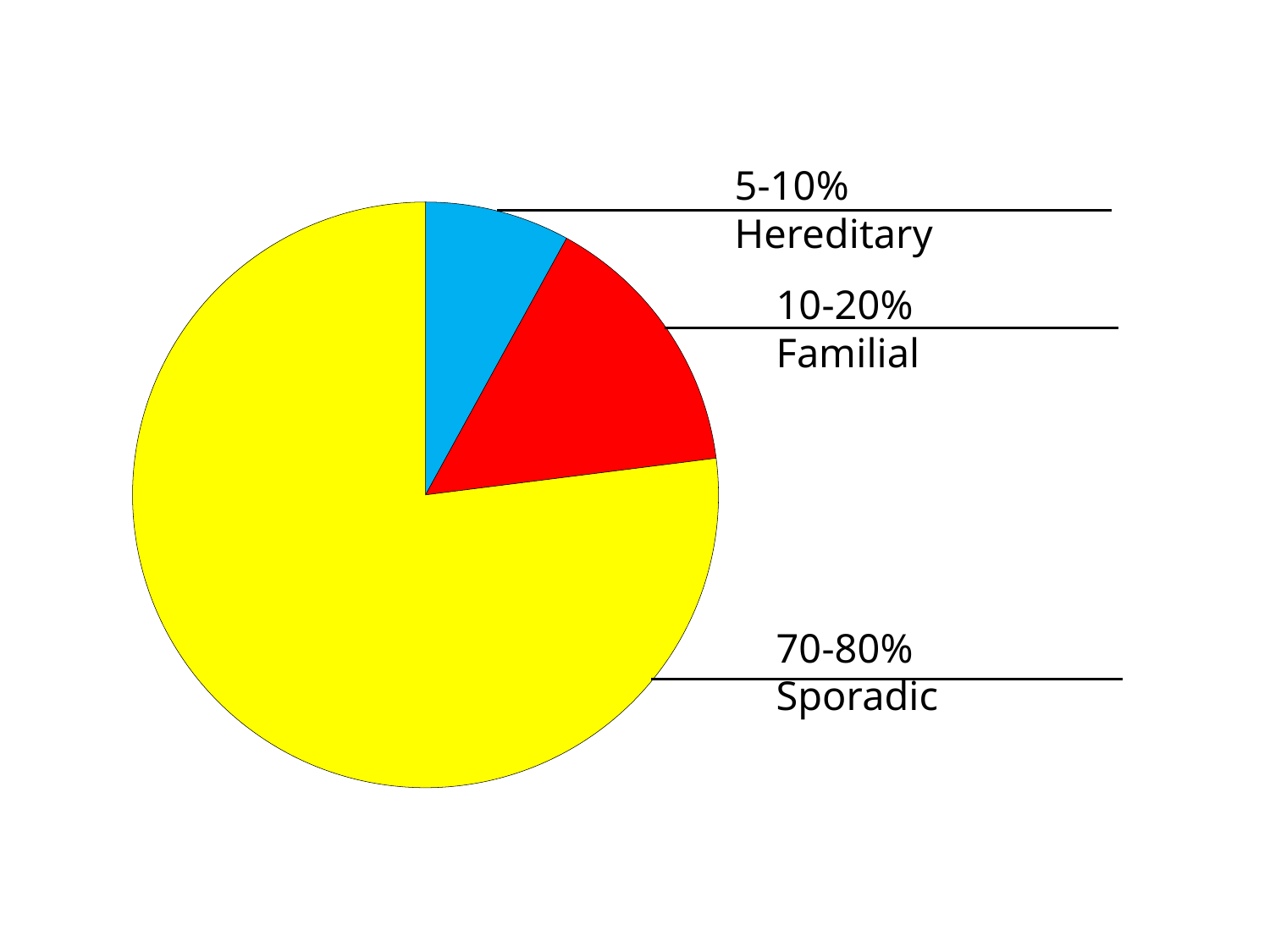
What share is labelled for the Hereditary slice? 5-10% What share is labelled for the Familial slice? 10-20% How many slices does the pie chart have? 3 What share is labelled for the Sporadic slice? 70-80% What kind of chart is shown on the slide? pie chart Which slice is larger, Familial or Hereditary? Familial What colour is the Sporadic slice? yellow What colour is the Hereditary slice? blue Which slice of the pie is the smallest? Hereditary Which slice is larger, Sporadic or Familial? Sporadic Which slice of the pie is the largest? Sporadic